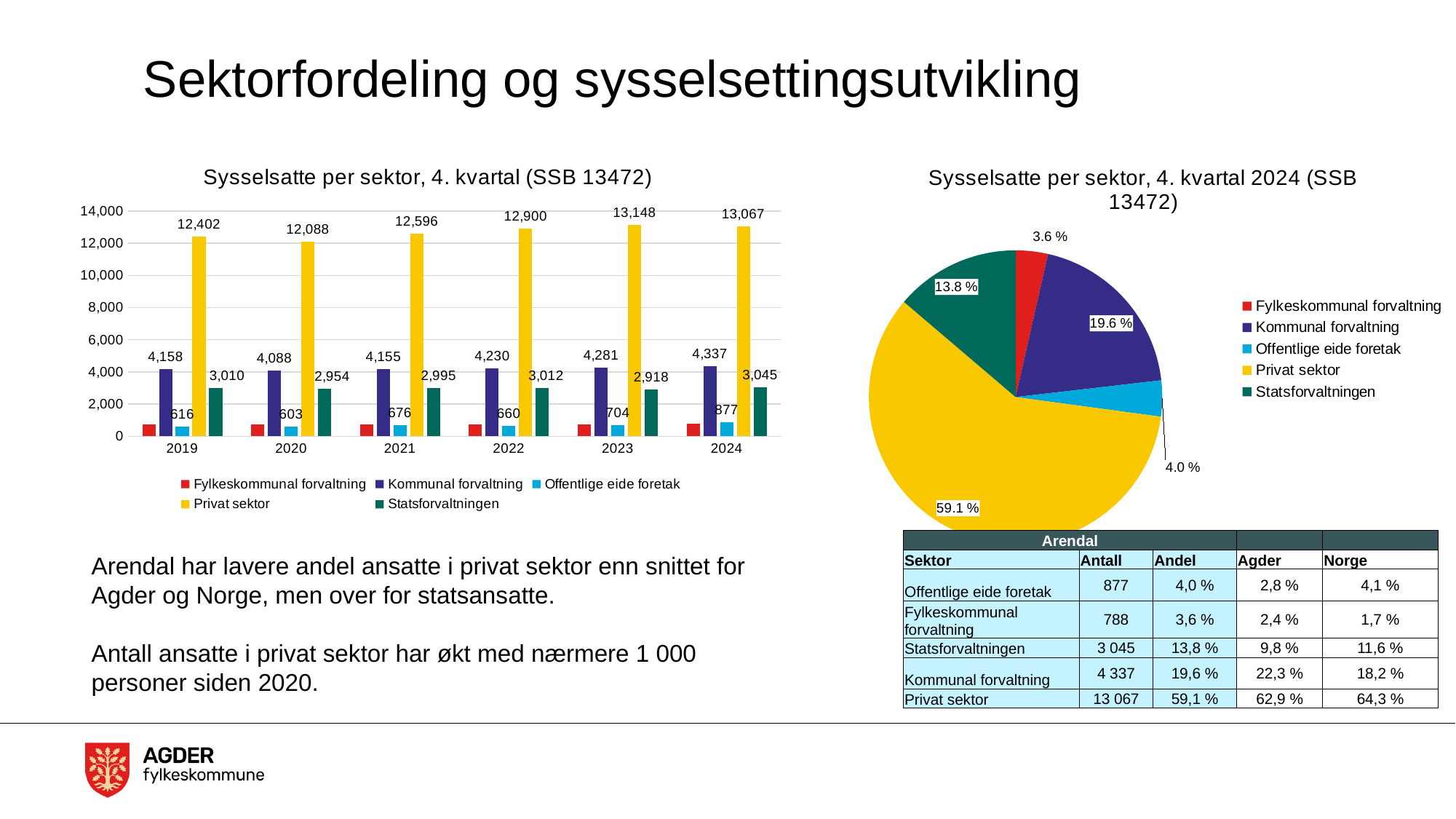
In the bar chart 'Sysselsatte per sektor, 4. kvartal (SSB 13472)', in which year is the Privat sektor value highest? 2023 In the bar chart 'Sysselsatte per sektor, 4. kvartal (SSB 13472)', does the Kommunal forvaltning value rise or fall from 2020 to 2024? rise In the bar chart 'Sysselsatte per sektor, 4. kvartal (SSB 13472)', in which year is the Statsforvaltningen value lowest? 2023 In the bar chart 'Sysselsatte per sektor, 4. kvartal (SSB 13472)', what is the value for Kommunal forvaltning in 2020? 4,088 In the bar chart 'Sysselsatte per sektor, 4. kvartal (SSB 13472)', what is the difference between the Privat sektor values for 2024 and 2020? 979 How many series does the legend of the bar chart 'Sysselsatte per sektor, 4. kvartal (SSB 13472)' list? 5 In the pie chart 'Sysselsatte per sektor, 4. kvartal 2024 (SSB 13472)', what share does Statsforvaltningen have? 13.8 % In the bar chart 'Sysselsatte per sektor, 4. kvartal (SSB 13472)', which is larger: Statsforvaltningen in 2019 or Statsforvaltningen in 2024? 2024 How many years are shown on the x axis of the bar chart 'Sysselsatte per sektor, 4. kvartal (SSB 13472)'? 6 In the bar chart 'Sysselsatte per sektor, 4. kvartal (SSB 13472)', is the value for Fylkeskommunal forvaltning in 2024 greater or less than 2,000? less In the bar chart 'Sysselsatte per sektor, 4. kvartal (SSB 13472)', what is the value for Privat sektor in 2023? 13,148 In the bar chart 'Sysselsatte per sektor, 4. kvartal (SSB 13472)', what is the value for Offentlige eide foretak in 2024? 877